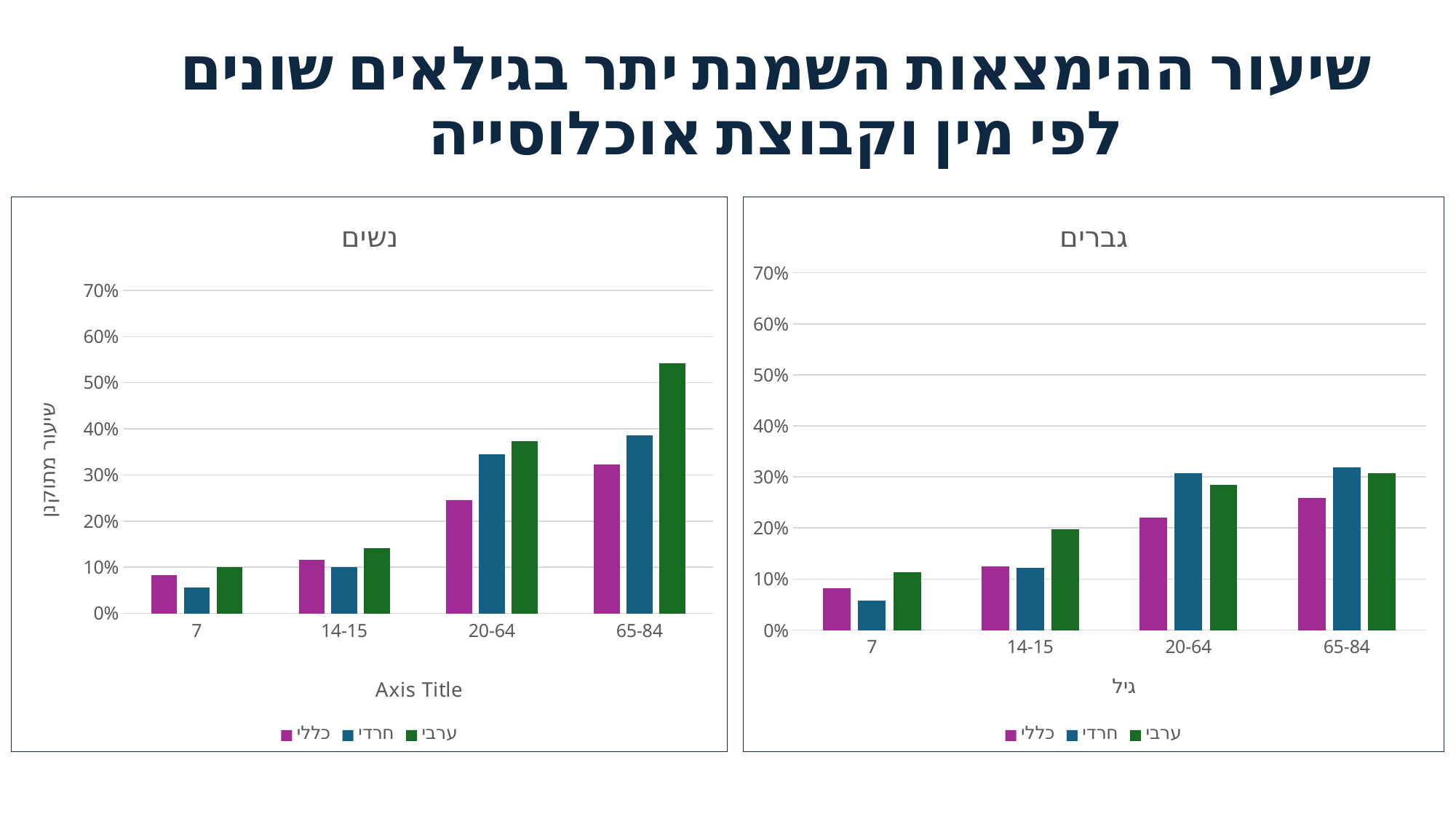
In the נשים chart, which age group has the highest value for ערבי? 65-84 In the גברים chart, which age group has the highest value for כללי? 65-84 In the נשים chart, do the values for כללי rise or fall as the age groups increase from 7 to 65-84? rise In the גברים chart, which is larger in the 20-64 age group, חרדי or ערבי? חרדי In the גברים chart, is the value for כללי in the 20-64 age group greater or less than 20%? greater In the נשים chart, is the value for ערבי in the 65-84 age group greater or less than 50%? greater What kind of chart is the נשים chart? bar chart In the נשים chart, which series has the lowest value in the 7 age group? חרדי How many age categories are shown on the x axis of the גברים chart? 4 What is the x-axis title of the גברים chart? גיל How many series does the legend of the נשים chart list? 3 In the נשים chart, is the value for כללי in the 65-84 age group greater or less than 30%? greater